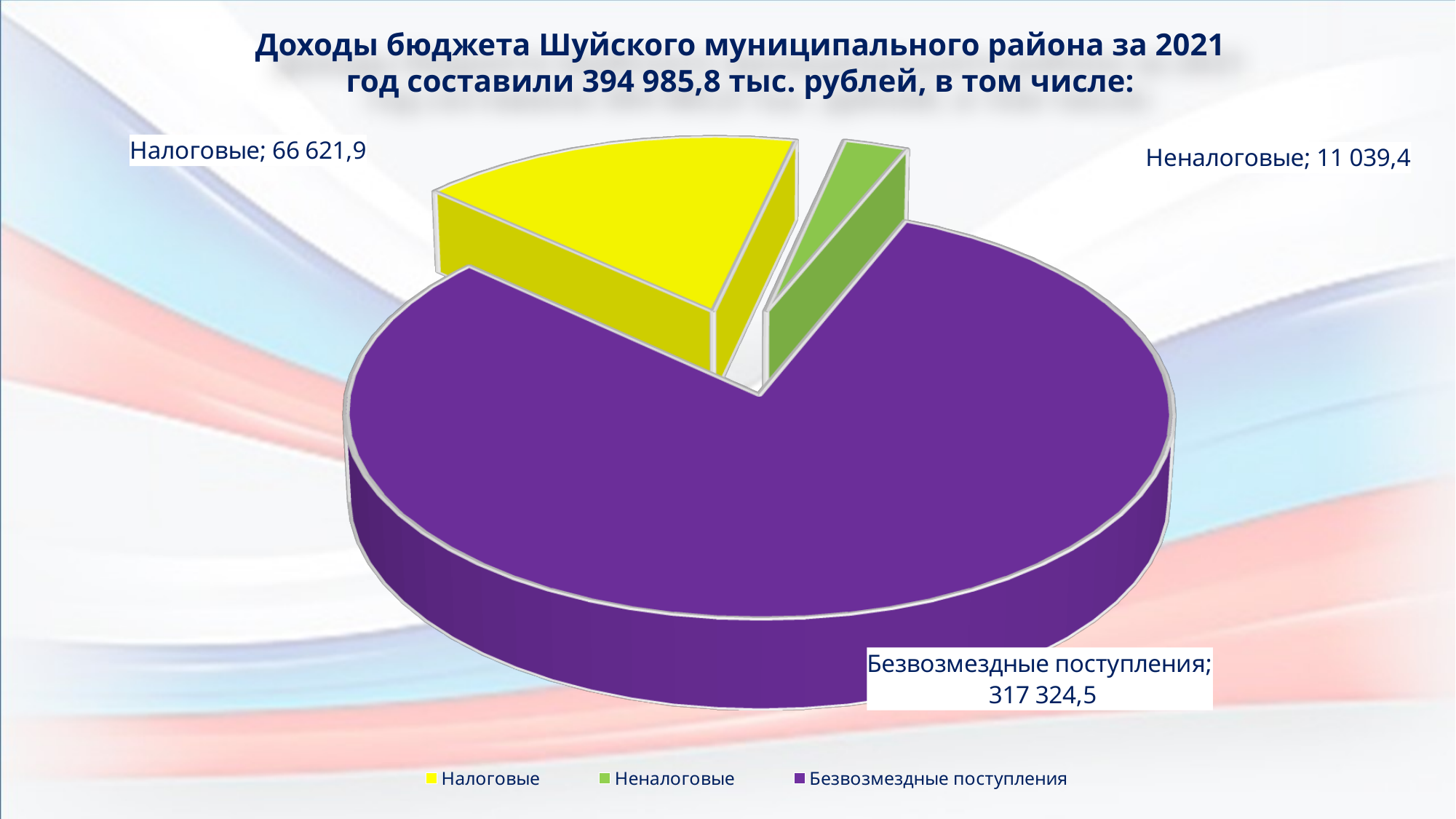
What colour is the Налоговые slice? Yellow What is the value for Неналоговые? 11 039,4 How many slices does the pie chart have? 3 Which is larger, Налоговые or Неналоговые? Налоговые Which category has the smallest slice of the pie? Неналоговые What share of the total do Безвозмездные поступления represent? 80.3% What is the value for Налоговые? 66 621,9 What is the difference between the values for Налоговые and Неналоговые? 55 582,5 Which category has the largest slice of the pie? Безвозмездные поступления What is the difference between the values for Безвозмездные поступления and Налоговые? 250 702,6 What kind of chart is shown on the slide? Pie chart What is the value for Безвозмездные поступления? 317 324,5